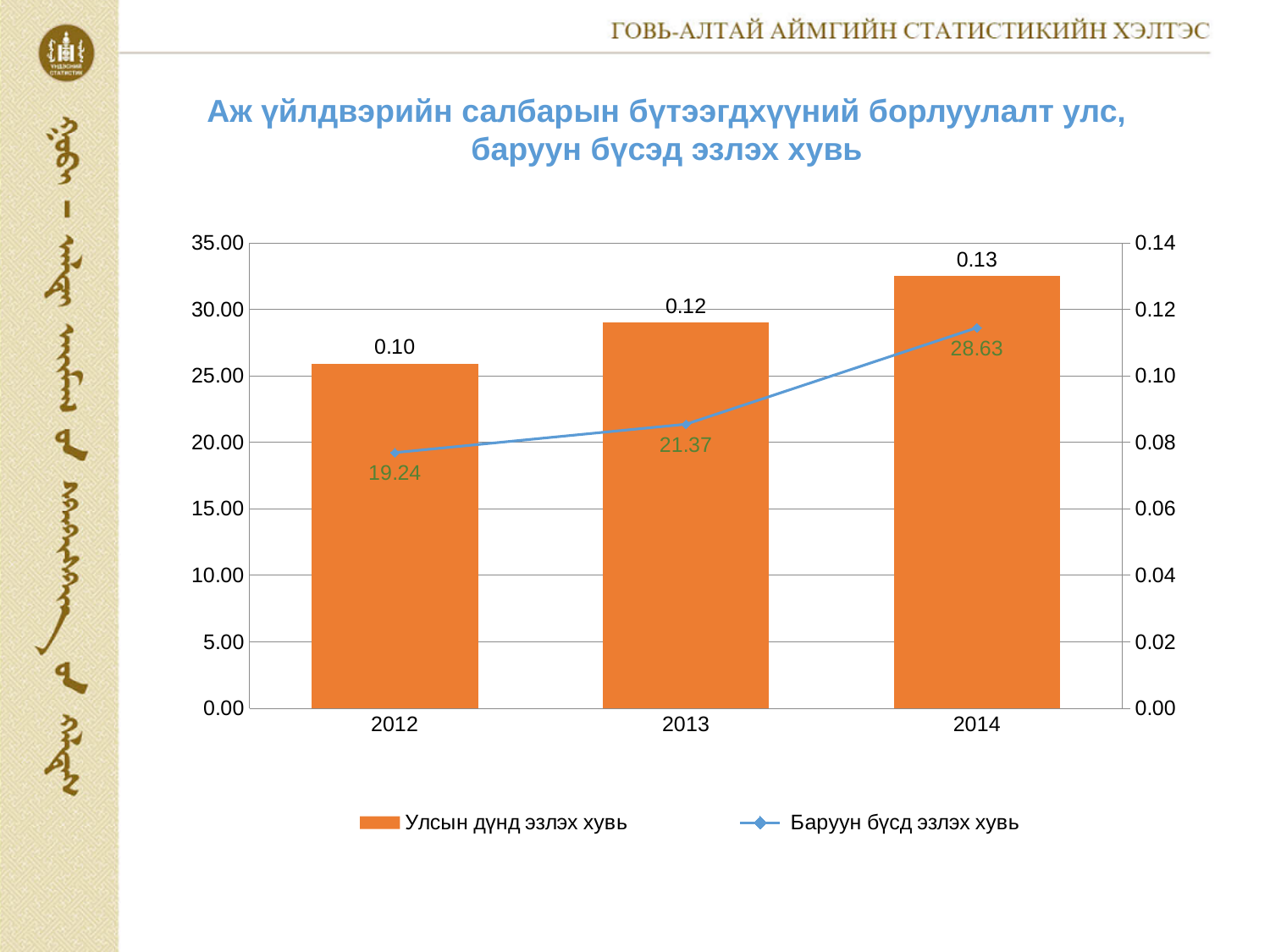
What is the value of Улсын дүнд эзлэх хувь for 2014? 0.13 What is the value of Баруун бүсд эзлэх хувь for 2014? 28.63 How many years are shown on the x axis? 3 Does Баруун бүсд эзлэх хувь rise or fall from 2012 to 2014? rise What is the difference between the Улсын дүнд эзлэх хувь values for 2013 and 2012? 0.02 What is the value of Улсын дүнд эзлэх хувь for 2012? 0.10 Which year has a larger Баруун бүсд эзлэх хувь value, 2012 or 2013? 2013 In which year is Улсын дүнд эзлэх хувь lowest? 2012 What is the value of Баруун бүсд эзлэх хувь for 2013? 21.37 How many series does the legend list? 2 What is the difference between the Баруун бүсд эзлэх хувь values for 2014 and 2012? 9.39 In which year is Баруун бүсд эзлэх хувь highest? 2014